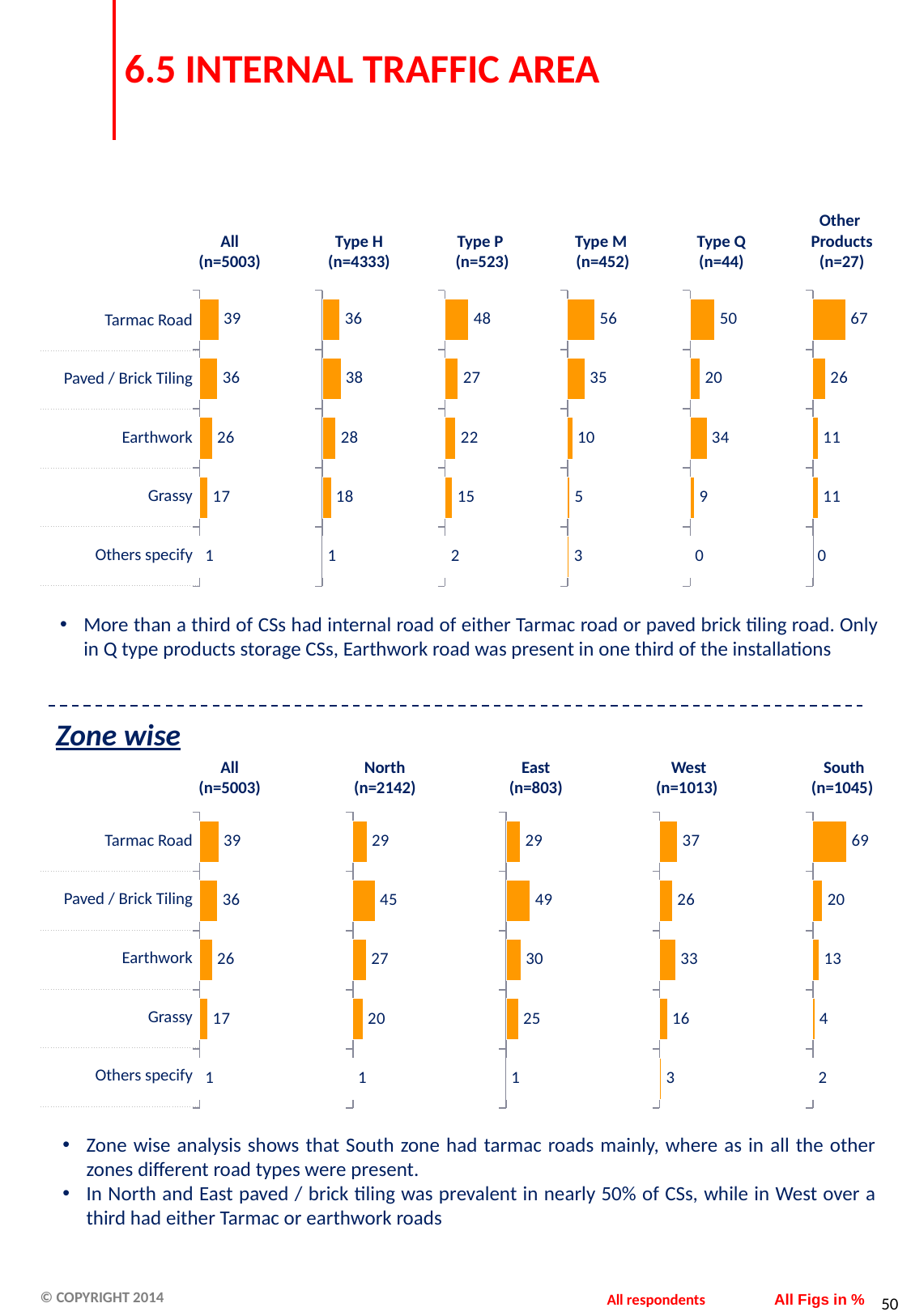
How many categories are shown in each chart of the Zone wise set? 5 In the Zone wise set of charts, which category has the highest value in the North (n=2142) chart? Paved / Brick Tiling In the top set of charts (by product type), what is the value for Earthwork in the Type Q (n=44) chart? 34 In the Zone wise set of charts, what is the value for Tarmac Road in the South (n=1045) chart? 69 In the top set of charts (by product type), which is larger in the Type H (n=4333) chart: Tarmac Road or Paved / Brick Tiling? Paved / Brick Tiling In the Zone wise set of charts, what is the difference between Tarmac Road and Grassy in the West (n=1013) chart? 21 In the top set of charts (by product type), which category has the highest value in the Other Products (n=27) chart? Tarmac Road In the top set of charts (by product type), which category has the lowest value in the Type H (n=4333) chart? Others specify In the Zone wise set of charts, what is the value for Paved / Brick Tiling in the East (n=803) chart? 49 In the top set of charts (by product type), what is the difference between Tarmac Road and Paved / Brick Tiling in the Type P (n=523) chart? 21 In the top set of charts (by product type), what is the value for Tarmac Road in the Type M (n=452) chart? 56 What type of chart is used for the All (n=5003) chart in the top set? Bar chart